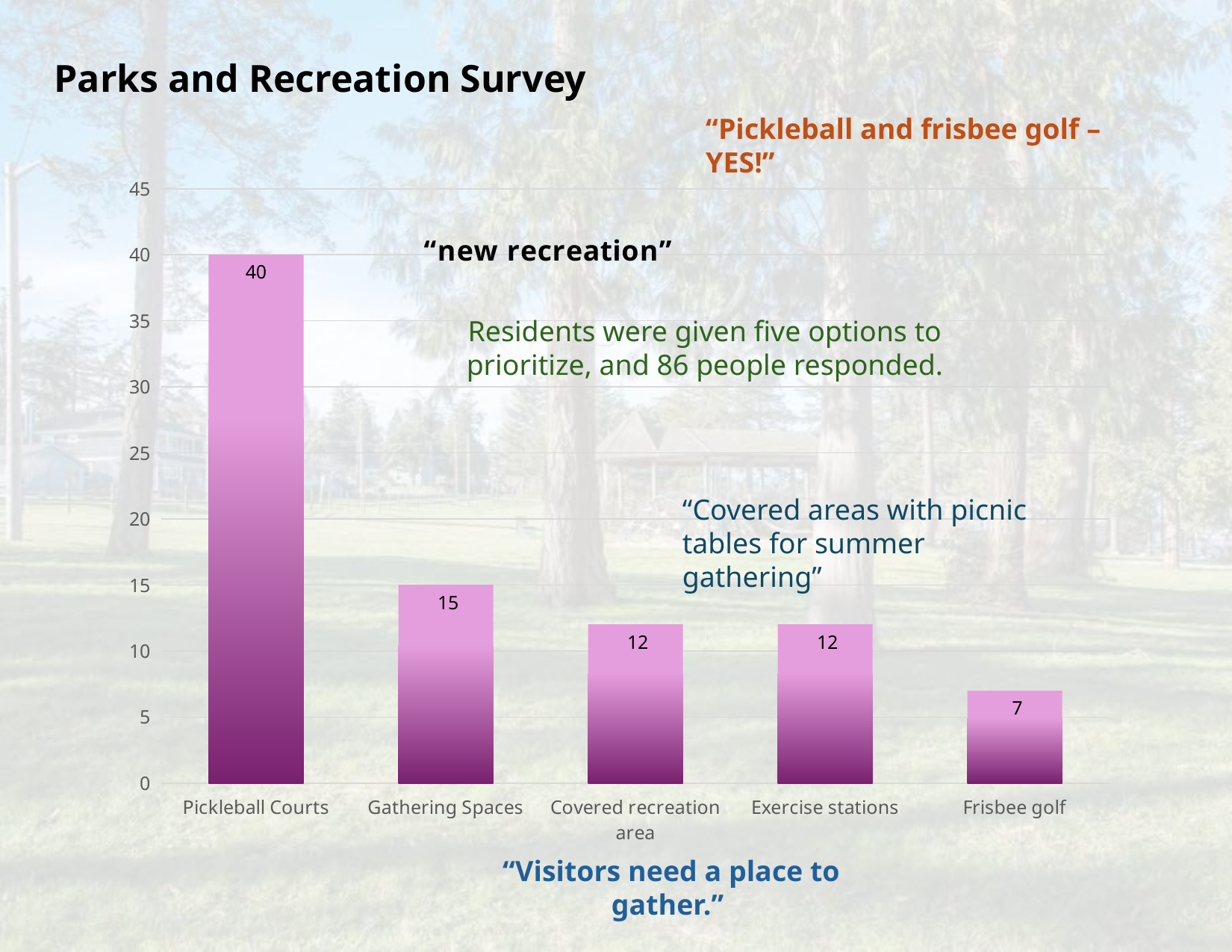
What is the difference between the values for Pickleball Courts and Gathering Spaces? 25 What is the title of the slide containing the chart? Parks and Recreation Survey Which category has the lowest value? Frisbee golf How many categories are shown on the x axis? 5 What is the value for Pickleball Courts? 40 What kind of chart is shown on the slide? bar chart What is the value for Exercise stations? 12 What is the value for Gathering Spaces? 15 What is the value for Frisbee golf? 7 Is the value for Covered recreation area greater or less than 10? greater Which category has the highest value? Pickleball Courts Which is larger, the value for Gathering Spaces or the value for Frisbee golf? Gathering Spaces